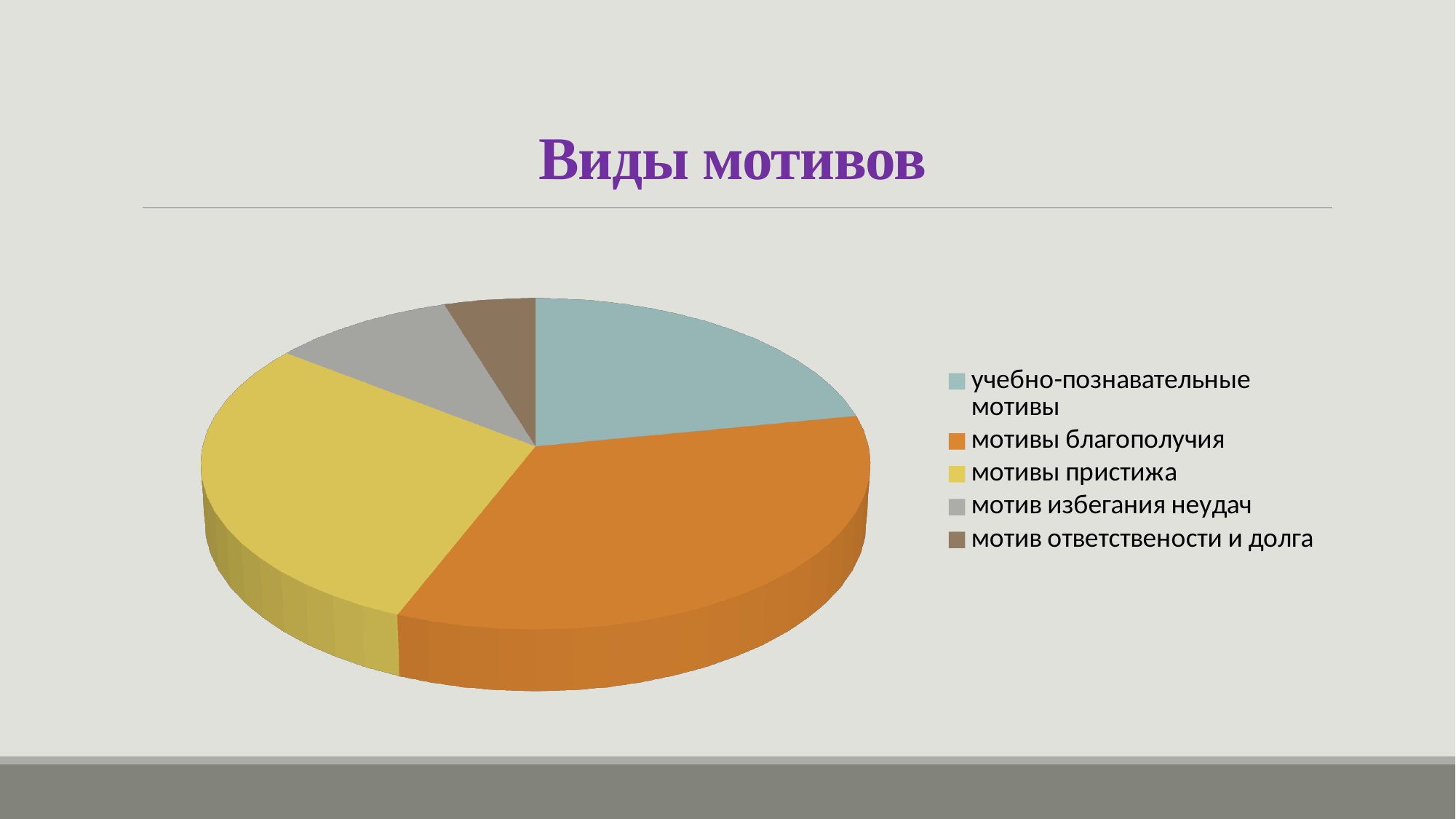
Which slice is larger: мотив избегания неудач or мотив ответствености и долга? мотив избегания неудач What kind of chart is shown on the slide? pie chart Which slice is larger: мотивы пристижа or мотив ответствености и долга? мотивы пристижа Which category has the smallest slice of the pie? мотив ответствености и долга What is the title of the chart on the slide? Виды мотивов What colour is the slice for мотивы пристижа? yellow Which category has the largest slice of the pie? мотивы благополучия How many categories (slices) does the pie chart have? 5 Which slice is larger: учебно-познавательные мотивы or мотив избегания неудач? учебно-познавательные мотивы